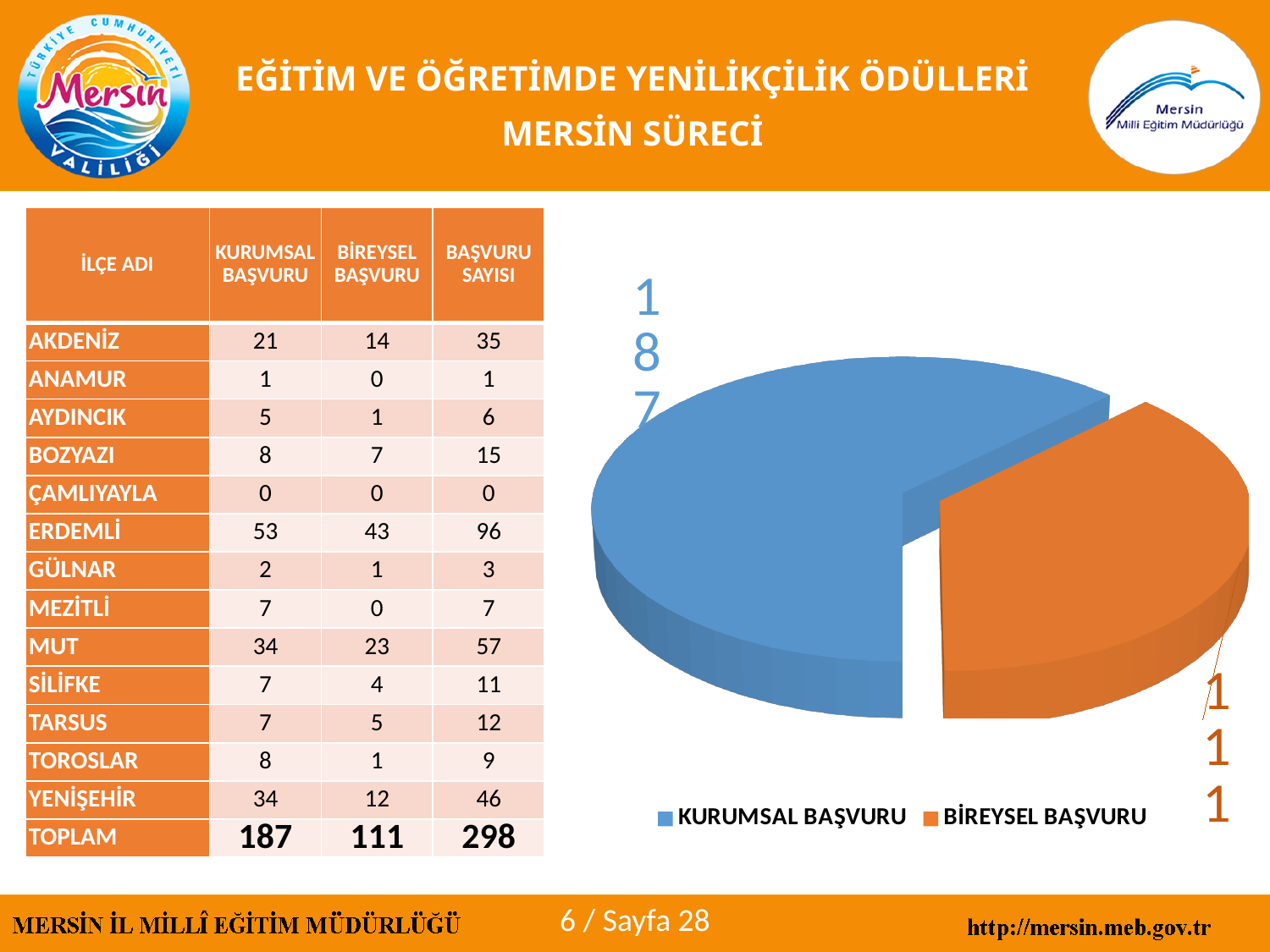
How many entries does the pie chart legend list? 2 What is the total of the two values shown in the pie chart? 298 What is the value for BİREYSEL BAŞVURU in the pie chart? 111 What colour is the KURUMSAL BAŞVURU slice in the pie chart? blue Which slice of the pie chart is the smallest? BİREYSEL BAŞVURU What colour is the BİREYSEL BAŞVURU slice in the pie chart? orange What is the value for KURUMSAL BAŞVURU in the pie chart? 187 How many slices does the pie chart have? 2 What kind of chart is shown on the slide? pie chart Which is larger in the pie chart, KURUMSAL BAŞVURU or BİREYSEL BAŞVURU? KURUMSAL BAŞVURU What is the difference between the KURUMSAL BAŞVURU and BİREYSEL BAŞVURU values in the pie chart? 76 Which slice of the pie chart is the largest? KURUMSAL BAŞVURU